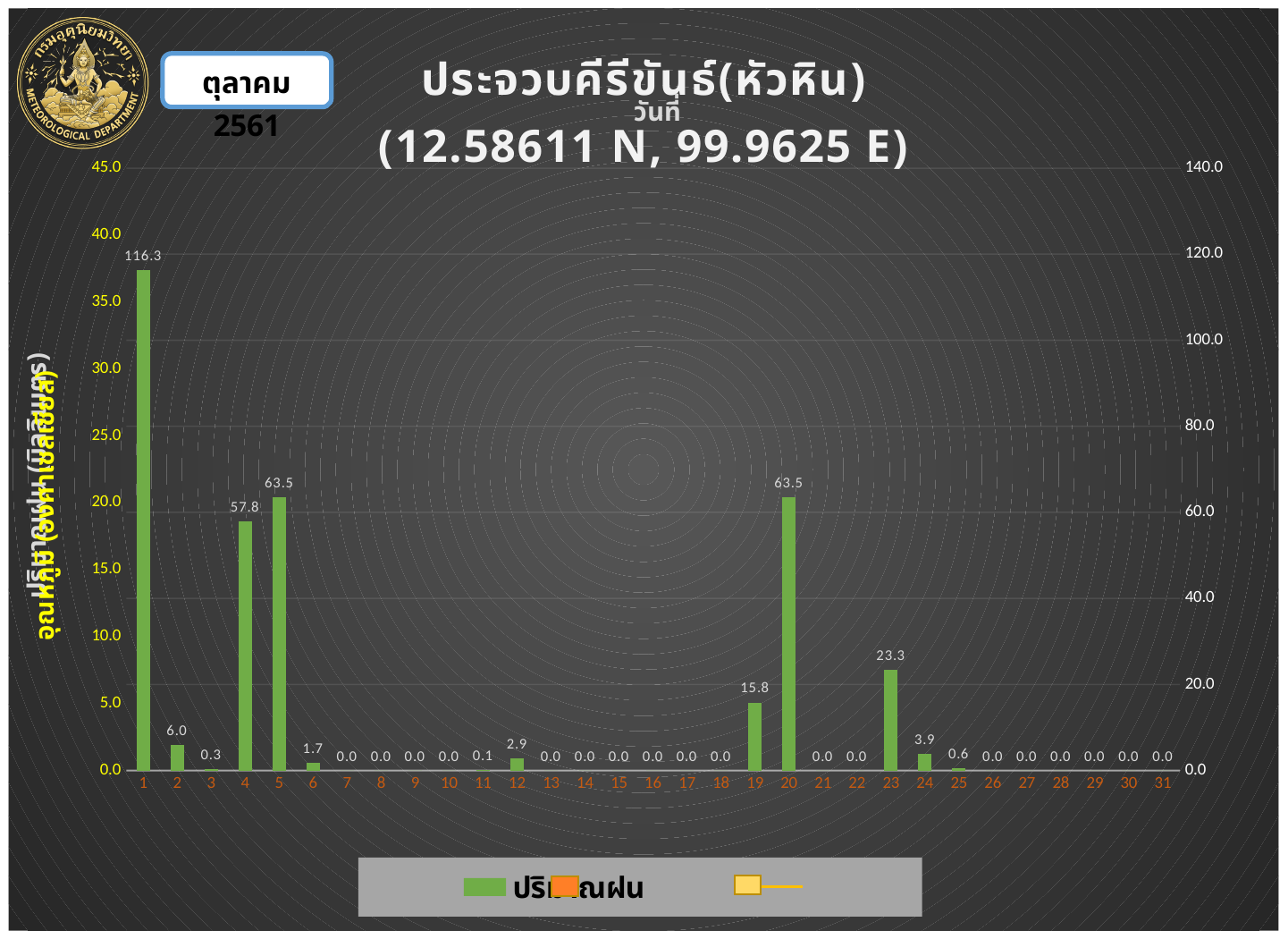
What is the difference between the values for day 1 and day 20? 52.8 How many series does the legend list? 3 What is the value labelled on the bar for day 4? 57.8 Which day has the highest bar in the chart? 1 What is the value labelled on the bar for day 23? 23.3 What is the value labelled on the bar for day 12? 2.9 What is the difference between the values for day 5 and day 4? 5.7 What is the rainfall value shown for day 1? 116.3 Is the value for day 1 greater or less than 100 on the right-hand axis? greater Which has the larger value, day 19 or day 24? day 19 How many days are shown along the x axis? 31 What kind of chart is shown on the slide? bar chart